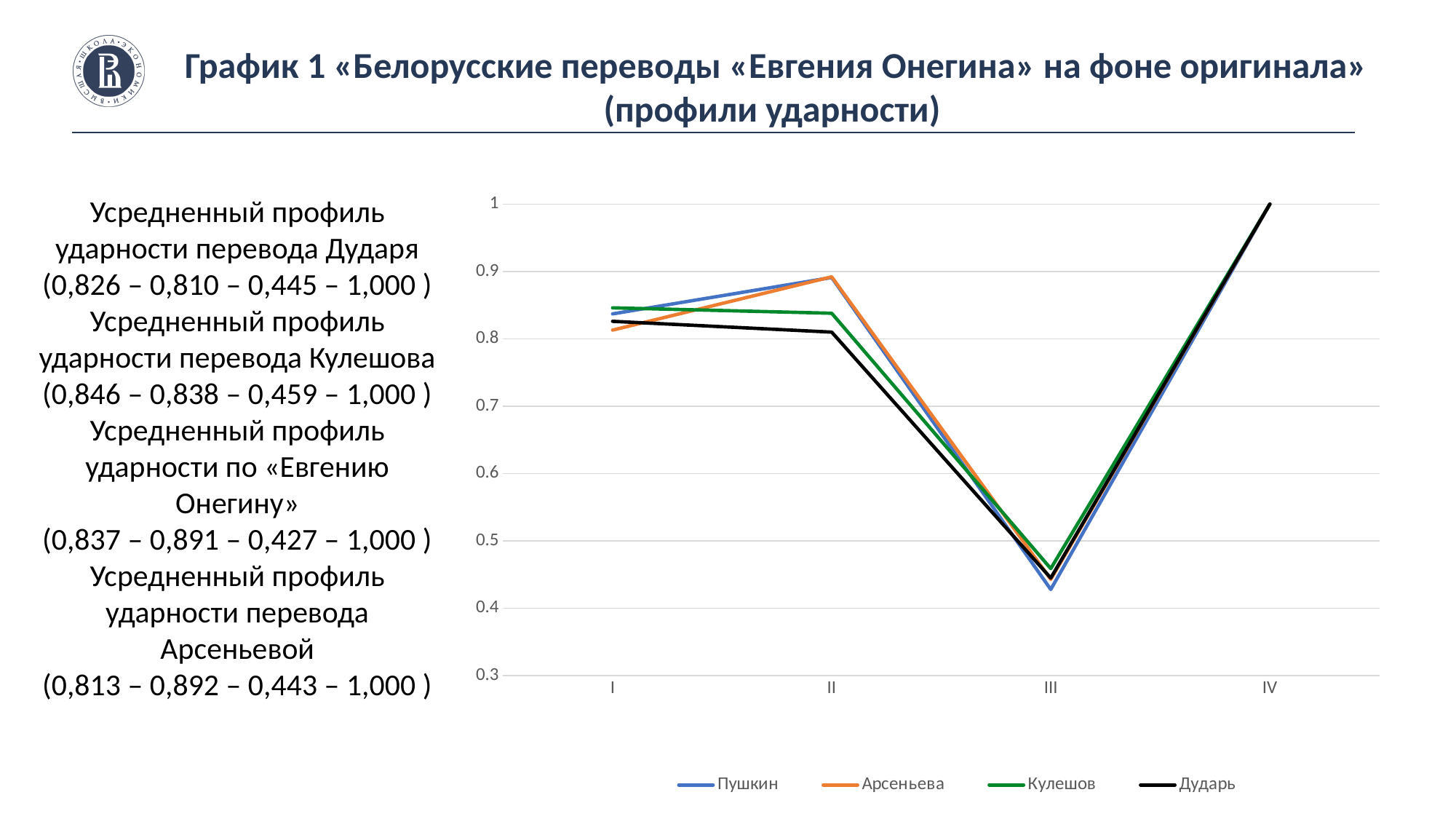
What is the value for Дударь at position III? 0,445 Do the values of the series rise or fall from position II to position III? fall Is the value for Кулешов at position III greater or less than 0.5? less What is the value for Арсеньева at position II? 0,892 What kind of chart is shown on the slide? line chart What is the value for Дударь at position IV? 1,000 How many series does the legend of the chart list? 4 What is the difference between the values for Арсеньева and Дударь at position II? 0,082 Which series has the lowest value at position II? Дударь What colour is the line for Дударь? black What is the value for Кулешов at position I? 0,846 How many positions are marked along the x axis of the chart? 4